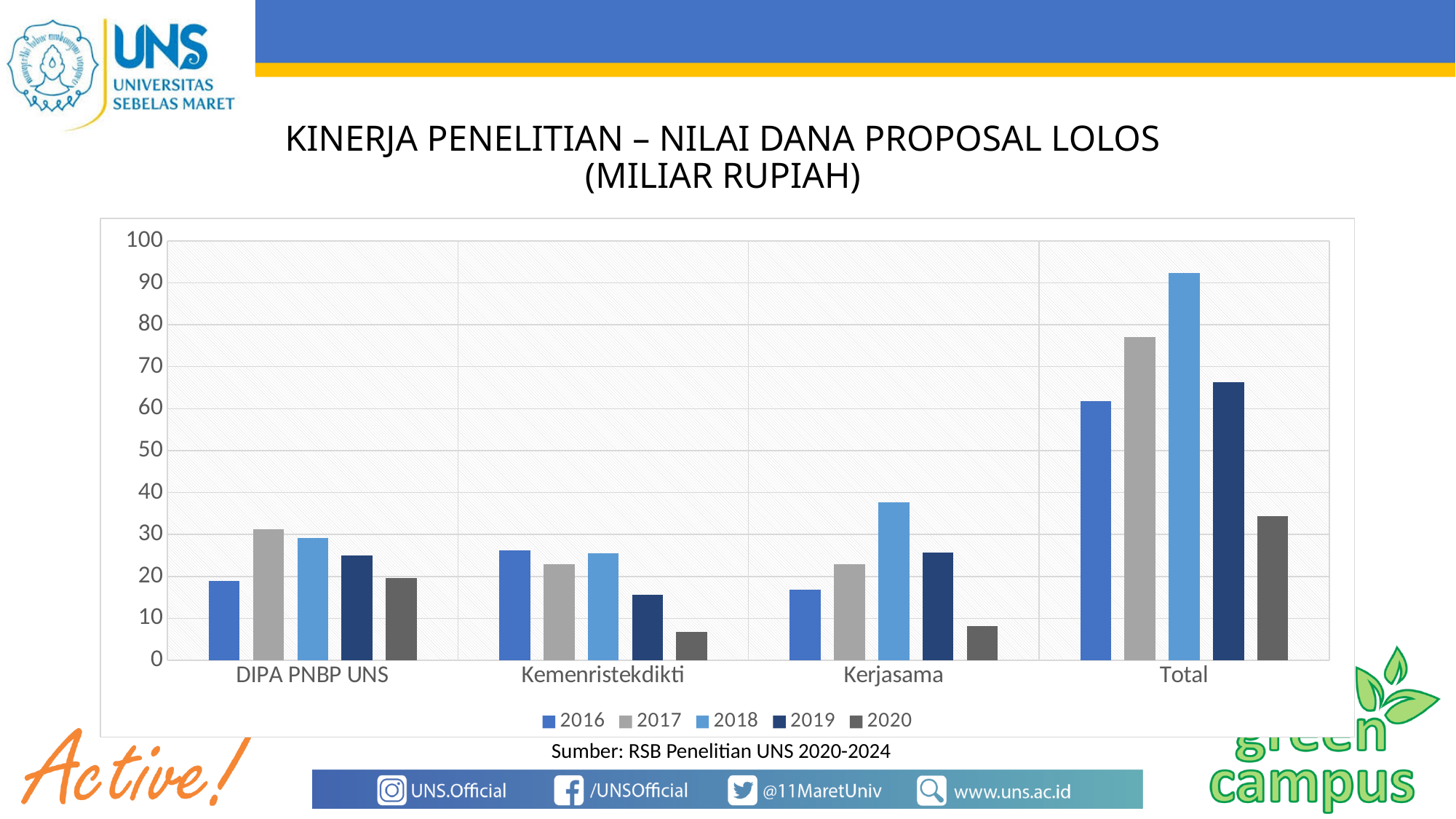
How many series does the legend list? 5 In the DIPA PNBP UNS category, which is larger: the 2016 bar or the 2017 bar? 2017 What source is cited below the chart? RSB Penelitian UNS 2020-2024 How many categories are shown on the x axis? 4 In the Kemenristekdikti category, which year has the lowest bar? 2020 In the Total category, which year has the highest bar? 2018 For the year 2018, which category has the larger value: Kemenristekdikti or Kerjasama? Kerjasama In the Kerjasama category, which year has the highest bar? 2018 Is the value for 2018 in the Total category greater or less than 90? greater What kind of chart is shown on the slide? bar chart Is the value for 2020 in the Total category greater or less than 30? greater Is the value for 2020 in the Kerjasama category greater or less than 10? less